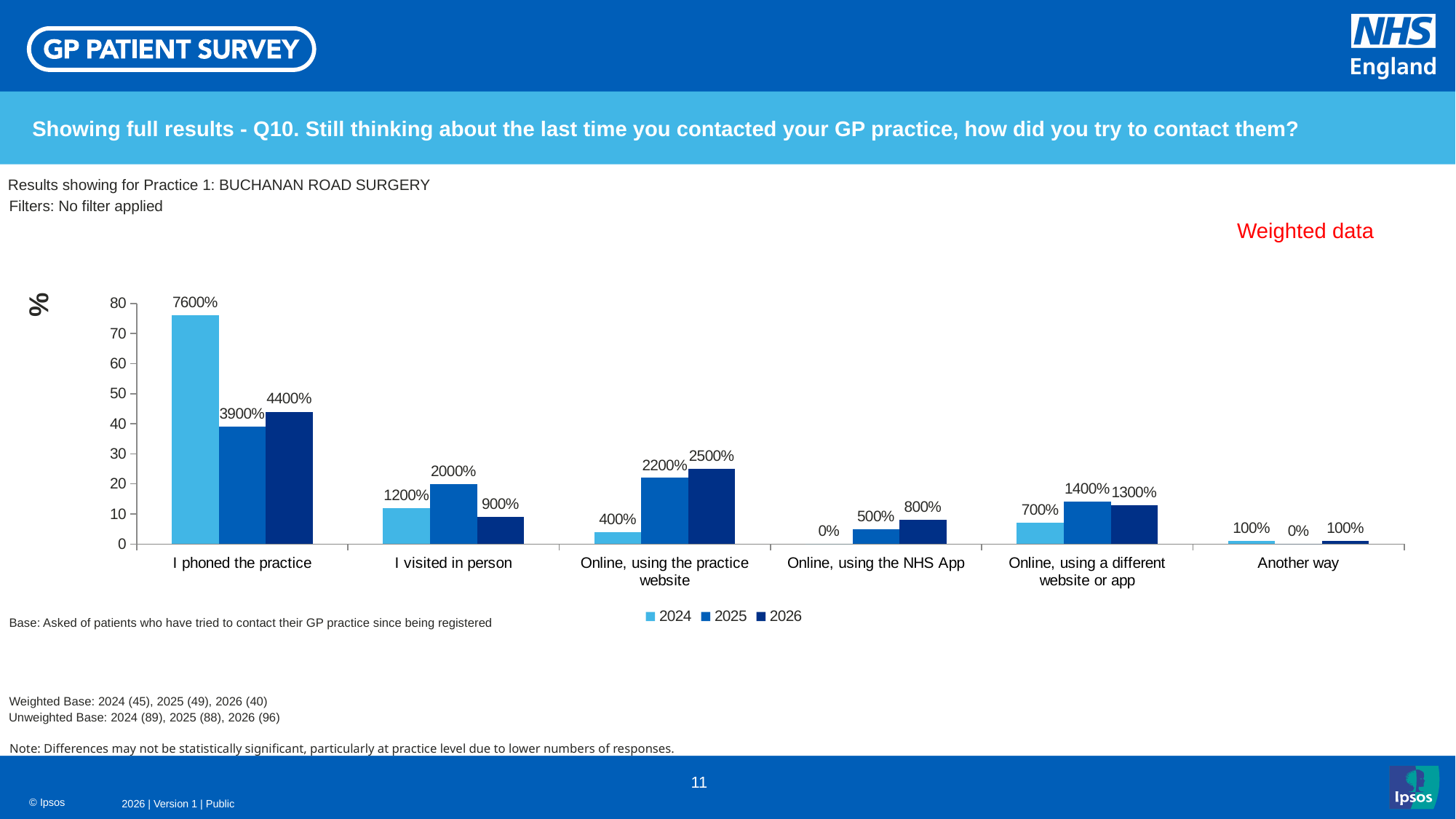
What is the 2026 value for 'Online, using the practice website'? 2500% Which years are listed in the chart legend? 2024, 2025, 2026 What is the 2025 value for 'Online, using the NHS App'? 500% What is the difference between the 2024 and 2025 values for 'I phoned the practice'? 3700% Which category has the lowest 2025 value? Another way What is the 2024 value for 'I phoned the practice'? 7600% Which category has the highest 2024 value? I phoned the practice For 'Online, using a different website or app', which is larger: the 2025 value or the 2026 value? 2025 How many categories are shown on the x axis? 6 What kind of chart is shown on the slide? Bar chart What is the 2026 value for 'I visited in person'? 900% How many series does the legend list? 3